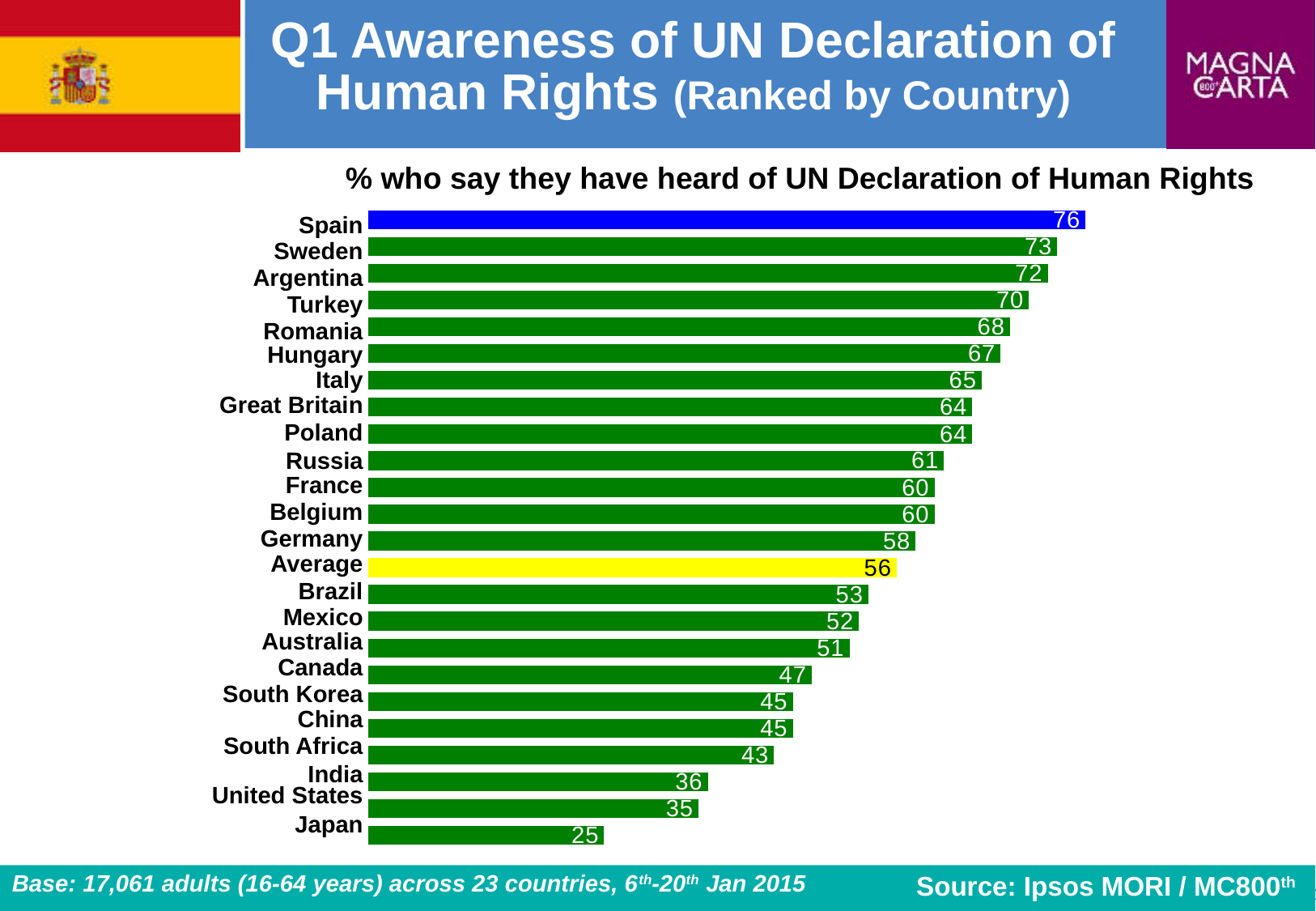
What is the value shown for the Average bar? 56 What type of chart is shown on the slide? Bar chart Which has a higher value, Canada or Brazil? Brazil What is the difference between the values for Sweden and the Average? 17 How many countries are shown in the chart (excluding the Average bar)? 23 What colour is the bar for the Average? Yellow Which country has the lowest awareness of the UN Declaration of Human Rights? Japan What percentage of people in Spain say they have heard of the UN Declaration of Human Rights? 76 What is the value shown for Germany? 58 Which has a higher value, India or United States? India What is the difference between the values for Spain and Japan? 51 Which country has the highest awareness of the UN Declaration of Human Rights? Spain